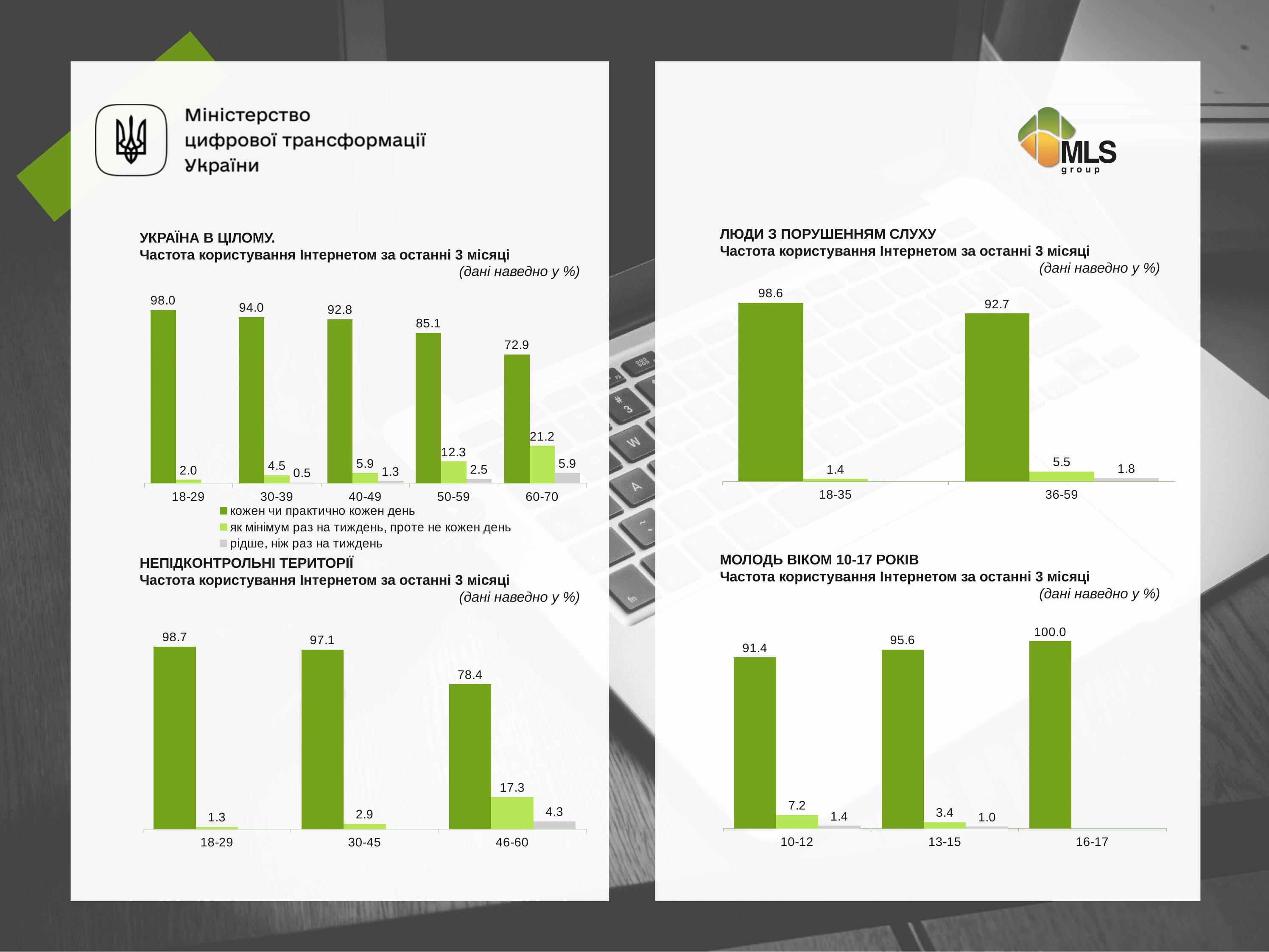
In the chart titled "НЕПІДКОНТРОЛЬНІ ТЕРИТОРІЇ", what is the value for the 46-60 group for "рідше, ніж раз на тиждень"? 4.3 In the chart titled "УКРАЇНА В ЦІЛОМУ", what is the value for the 18-29 age group for the series "кожен чи практично кожен день"? 98.0 In the chart titled "МОЛОДЬ ВІКОМ 10-17 РОКІВ", what is the value for the 16-17 group for "кожен чи практично кожен день"? 100.0 How many series does the legend under the chart titled "УКРАЇНА В ЦІЛОМУ" list? 3 In the chart titled "ЛЮДИ З ПОРУШЕННЯМ СЛУХУ", which group has the higher value for "кожен чи практично кожен день", 18-35 or 36-59? 18-35 In the chart titled "УКРАЇНА В ЦІЛОМУ", how many age groups are shown on the x axis? 5 What type of chart is the chart titled "МОЛОДЬ ВІКОМ 10-17 РОКІВ"? bar chart In the chart titled "ЛЮДИ З ПОРУШЕННЯМ СЛУХУ", what is the value for the 36-59 group for "як мінімум раз на тиждень, проте не кожен день"? 5.5 In the chart titled "УКРАЇНА В ЦІЛОМУ", what is the difference between the "кожен чи практично кожен день" values for 18-29 and 60-70? 25.1 In the chart titled "НЕПІДКОНТРОЛЬНІ ТЕРИТОРІЇ", which age group has the highest value for "як мінімум раз на тиждень, проте не кожен день"? 46-60 In the chart titled "УКРАЇНА В ЦІЛОМУ", does the "кожен чи практично кожен день" value rise or fall as the age groups go from 18-29 to 60-70? fall In the chart titled "УКРАЇНА В ЦІЛОМУ", which age group has the lowest value for "кожен чи практично кожен день"? 60-70